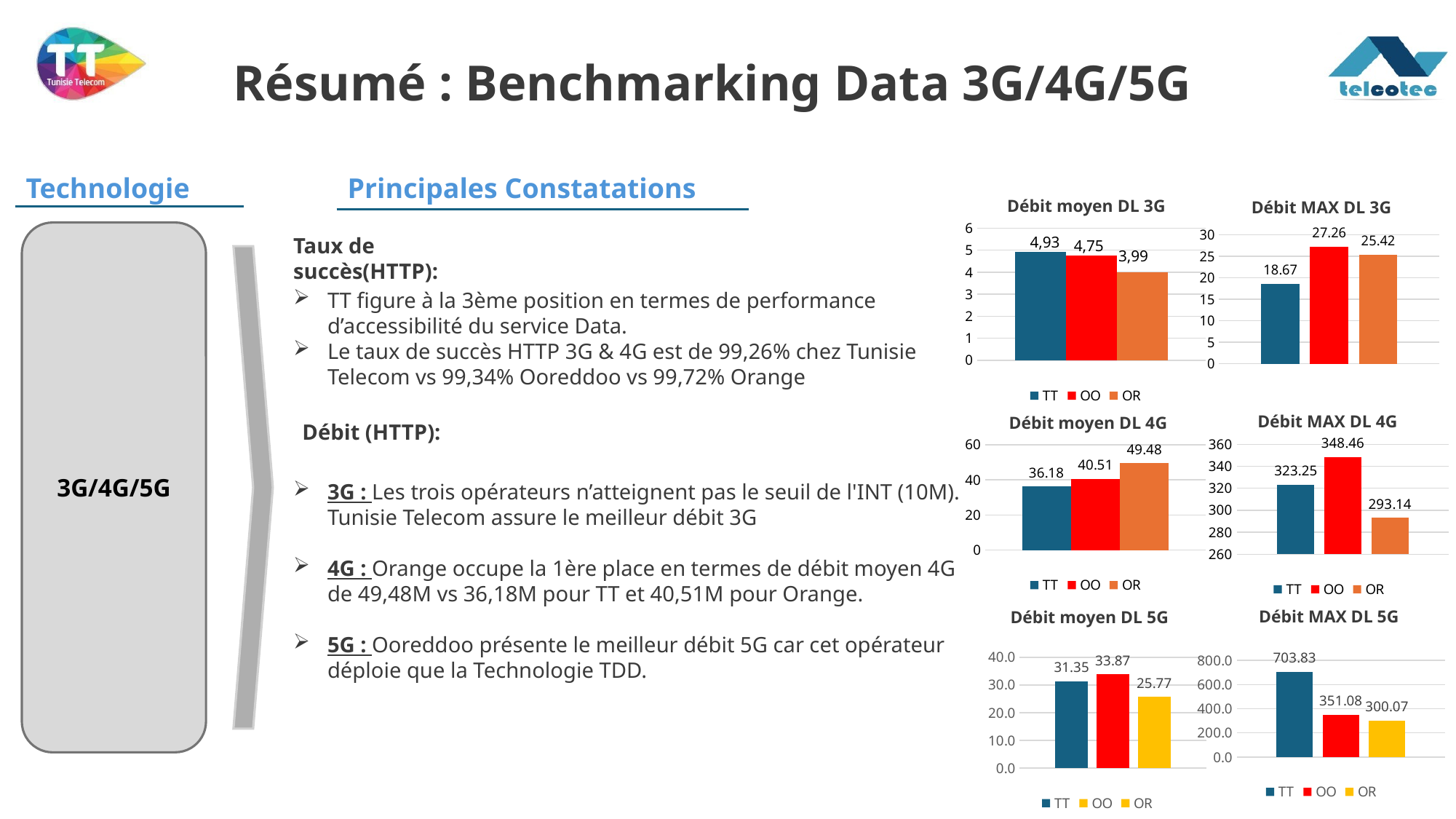
In the 'Débit moyen DL 3G' chart, what is the difference between the TT value and the OR value? 0,94 In the 'Débit moyen DL 3G' chart, what is the value for TT? 4,93 How many bars are plotted in the 'Débit moyen DL 3G' chart? 3 In the 'Débit MAX DL 5G' chart, what is the value for TT? 703.83 In the 'Débit MAX DL 4G' chart, which operator has the lowest value? OR In the 'Débit moyen DL 5G' chart, which is larger, the value for TT or the value for OO? OO In the 'Débit MAX DL 4G' chart, what is the value for OR? 293.14 In the 'Débit MAX DL 3G' chart, which operator has the highest value? OO How many series does the legend of the 'Débit MAX DL 4G' chart list? 3 In the 'Débit MAX DL 5G' chart, what is the difference between the TT value and the OO value? 352.75 In the 'Débit moyen DL 4G' chart, what is the difference between the OR value and the TT value? 13.30 What kind of chart is the 'Débit moyen DL 5G' chart? bar chart